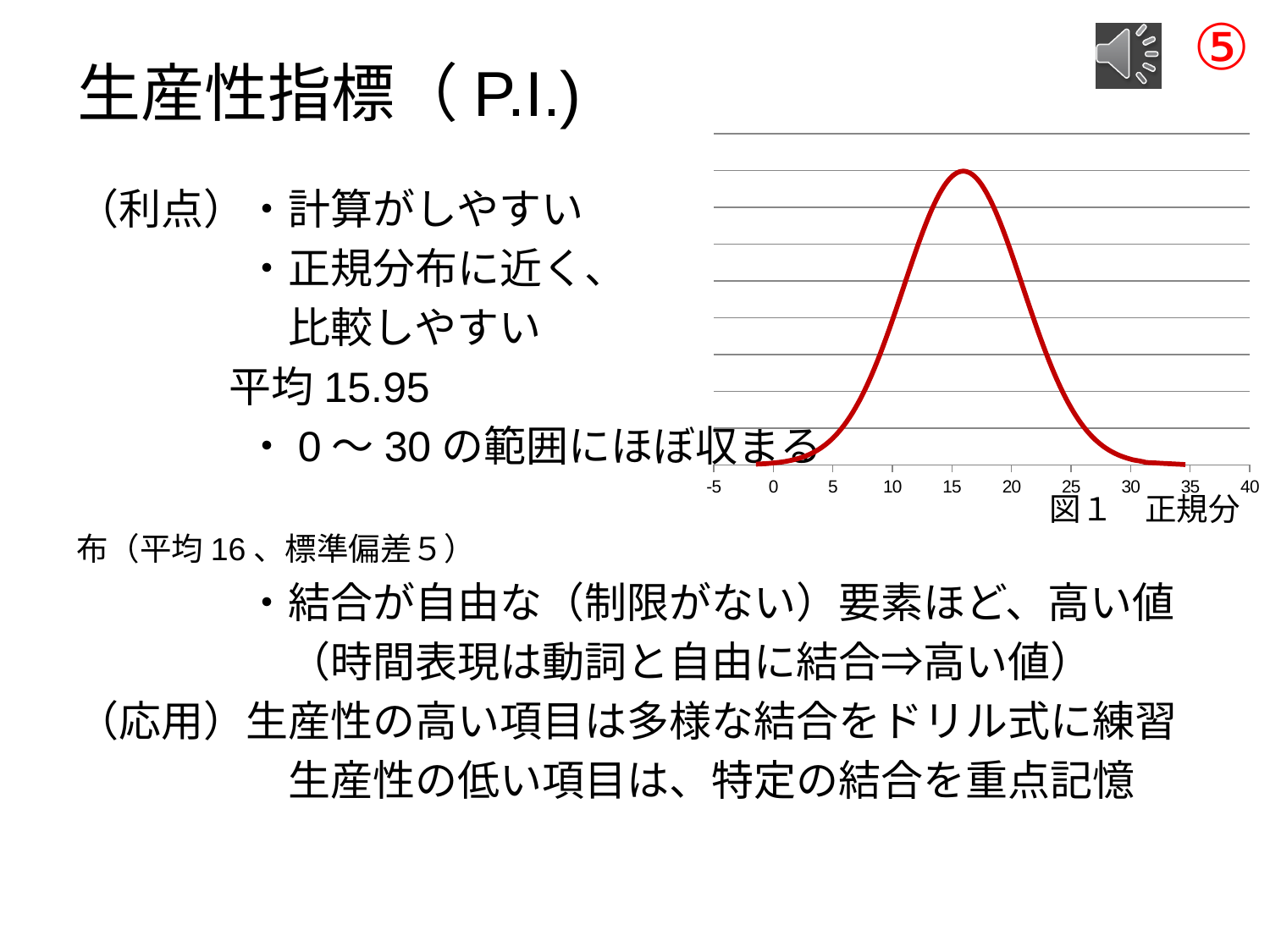
Is the curve higher at x = 0 or at x = 10? 10 According to the chart caption, what is the standard deviation of the normal distribution plotted? 5 What kind of chart is shown on the slide? line chart Is the curve higher at x = 15 or at x = 30? 15 Does the curve rise or fall as x goes from 20 to 40? fall How many tick labels are shown on the x axis of the chart? 10 Does the curve rise or fall as x goes from -5 to 15? rise Is the curve higher at x = 5 or at x = 20? 20 What is the highest value labelled on the x axis of the chart? 40 According to the chart caption, what is the mean of the normal distribution plotted? 16 What is the lowest value labelled on the x axis of the chart? -5 What is the figure number given in the chart caption? 図1